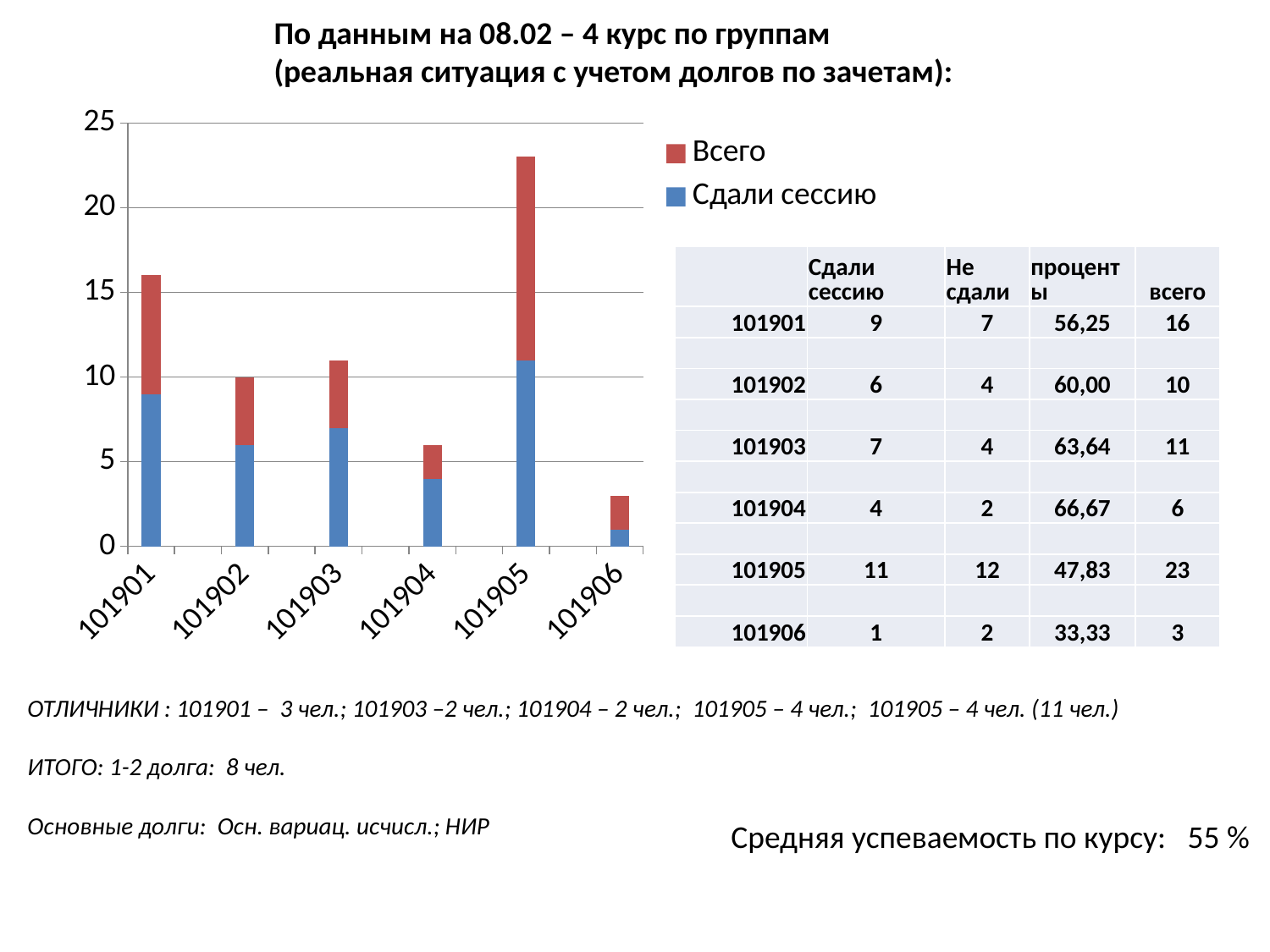
What is the 'Сдали сессию' value for group 101905? 11 Which group has a taller stacked bar, 101901 or 101902? 101901 What is the total height of the stacked bar for group 101906? 3 Which group has the tallest stacked bar in the chart? 101905 Which group has the shortest stacked bar in the chart? 101906 What kind of chart is shown on the slide? bar chart How many series does the chart legend list? 2 Is the total stacked bar for group 101905 greater or less than 20? greater By how much does the total for group 101905 exceed the total for group 101901? 7 How many groups (categories) are shown on the x axis of the chart? 6 What is the total height of the stacked bar for group 101901? 16 Which colour represents the 'Сдали сессию' series in the chart? blue